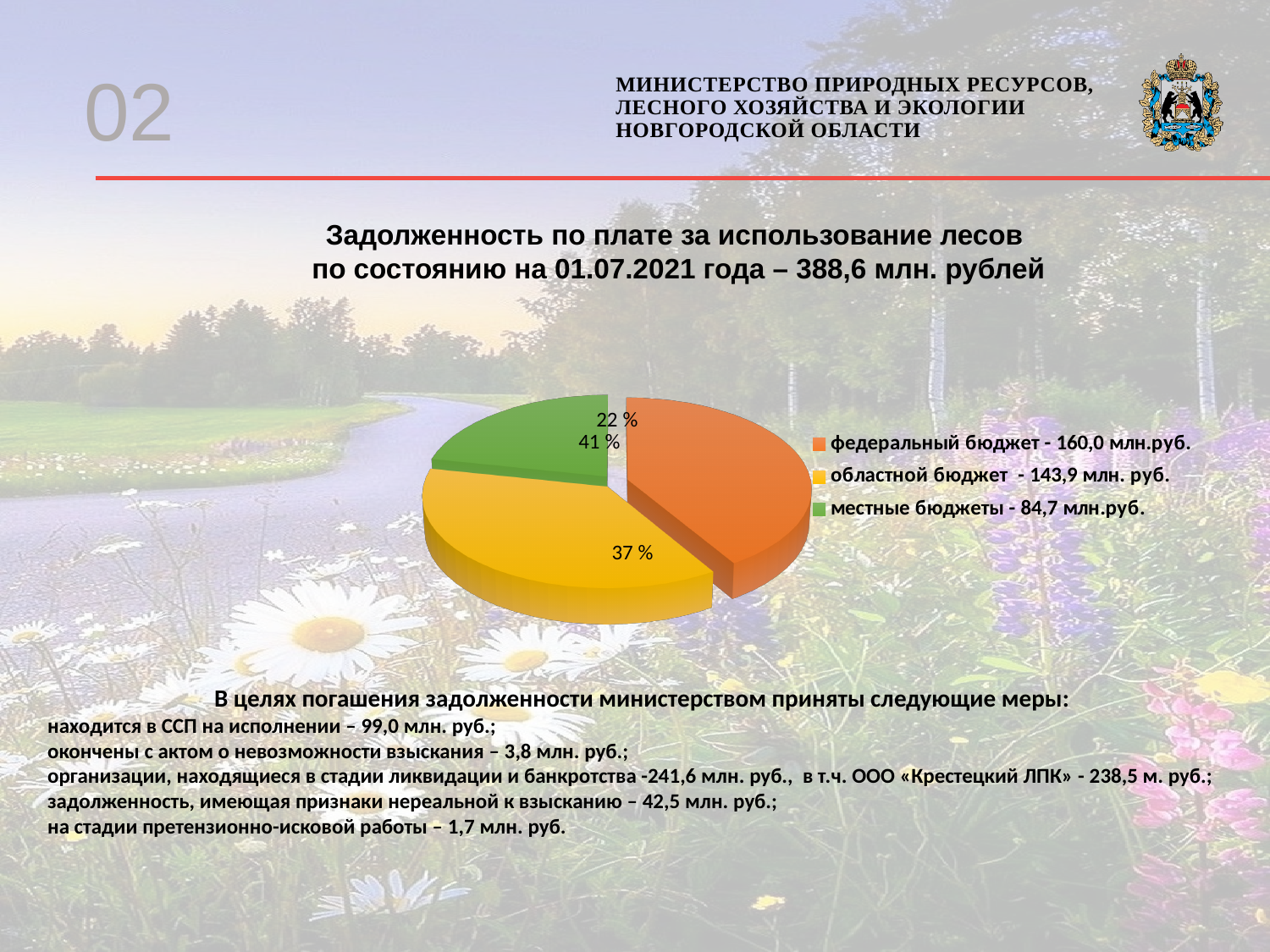
Which is larger, the value for федеральный бюджет or the value for областной бюджет? федеральный бюджет How many slices does the pie chart have? 3 What colour is the slice for местные бюджеты in the pie chart? green What kind of chart is shown on the slide? pie chart How many entries does the legend of the pie chart list? 3 Which budget category has the largest slice of the pie chart? федеральный бюджет Which budget category has the smallest slice of the pie chart? местные бюджеты According to the legend, what is the value for областной бюджет? 143,9 млн. руб. What percentage share of the pie is shown for the smallest slice? 22 % According to the legend, what is the value for федеральный бюджет? 160,0 млн.руб. What percentage share of the pie is shown for the yellow slice (областной бюджет)? 37 % According to the legend, what is the value for местные бюджеты? 84,7 млн.руб.